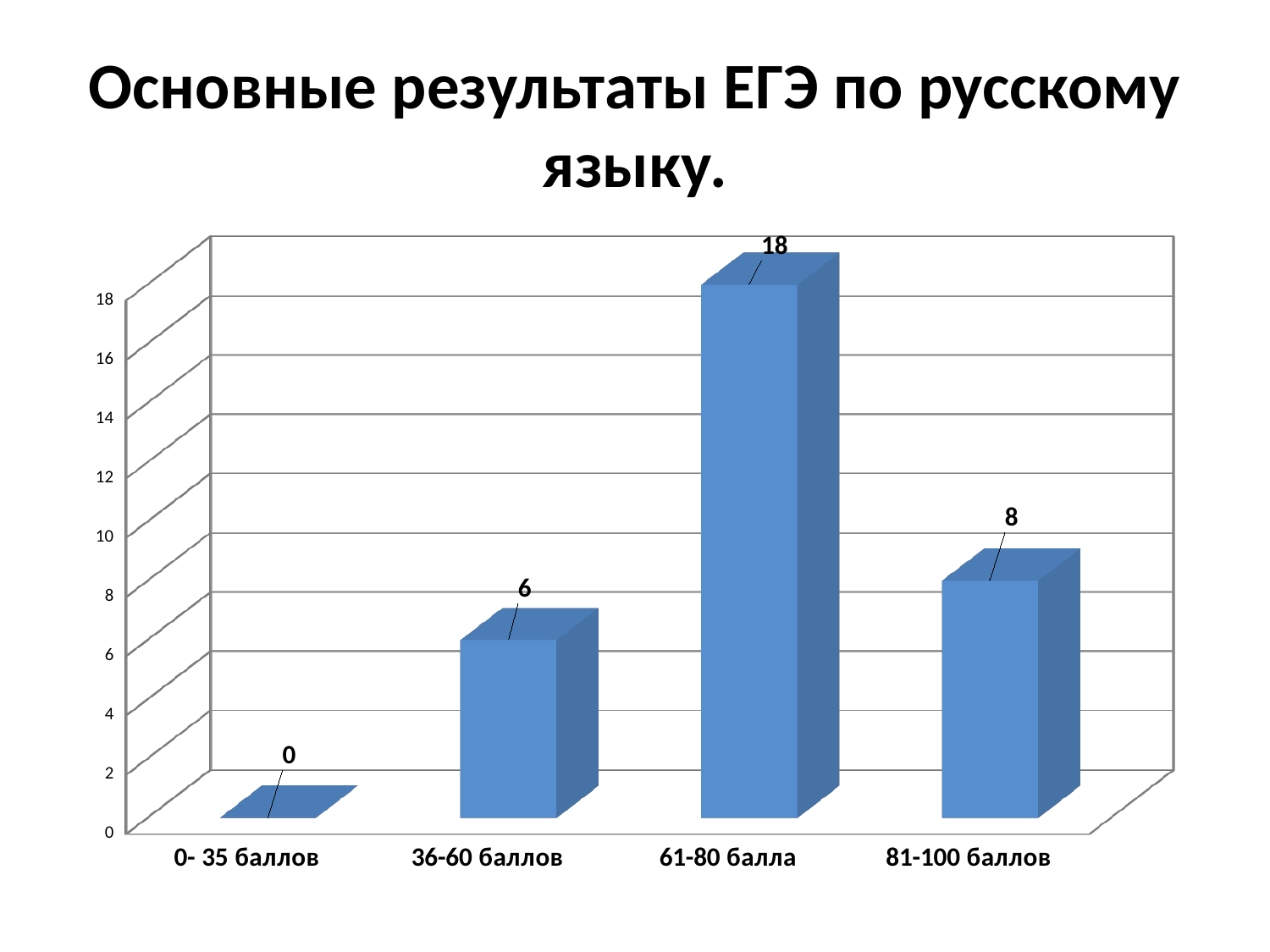
What is the value for the 0- 35 баллов category? 0 What is the value for the 61-80 балла category? 18 What is the difference between the values for 61-80 балла and 81-100 баллов? 10 Which category has the lowest value? 0- 35 баллов What is the value for the 81-100 баллов category? 8 What is the title of the slide? Основные результаты ЕГЭ по русскому языку. What is the difference between the values for 81-100 баллов and 36-60 баллов? 2 Which is larger, the value for 36-60 баллов or the value for 81-100 баллов? 81-100 баллов Which category has the highest value? 61-80 балла What kind of chart is shown on the slide? bar chart What is the value for the 36-60 баллов category? 6 How many categories are shown on the x axis? 4